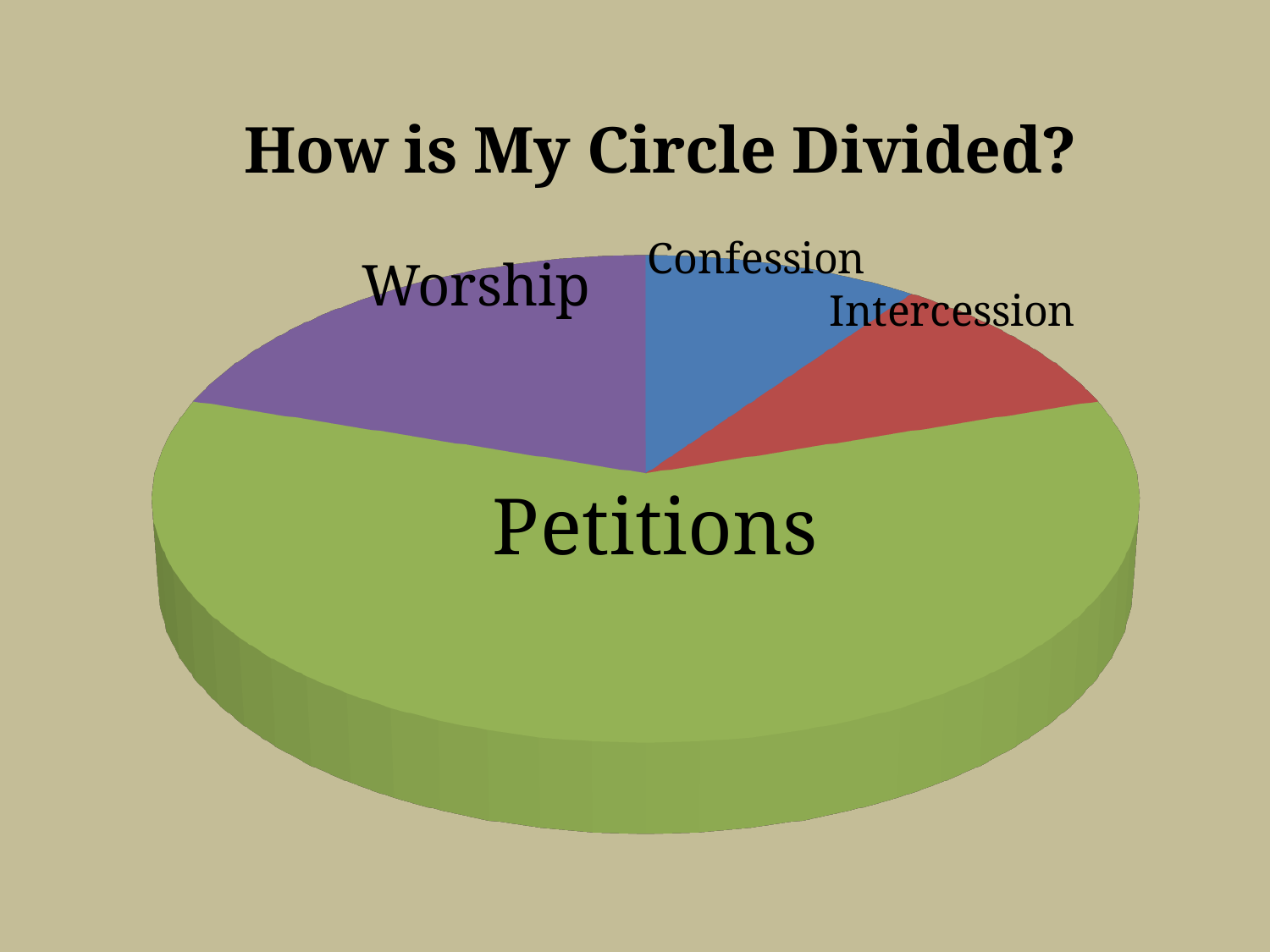
What kind of chart is shown on the slide? Pie chart What is the title of the chart? How is My Circle Divided? Is the Worship slice more or less than half of the pie? less How many slices does the pie chart have? 4 Which is larger, the Worship slice or the Confession slice? Worship Which is larger, the Petitions slice or the Worship slice? Petitions What colour is the Petitions slice? Green Which is larger, the Worship slice or the Intercession slice? Worship Which slice of the pie chart is the largest? Petitions Is the Petitions slice more or less than half of the pie? more